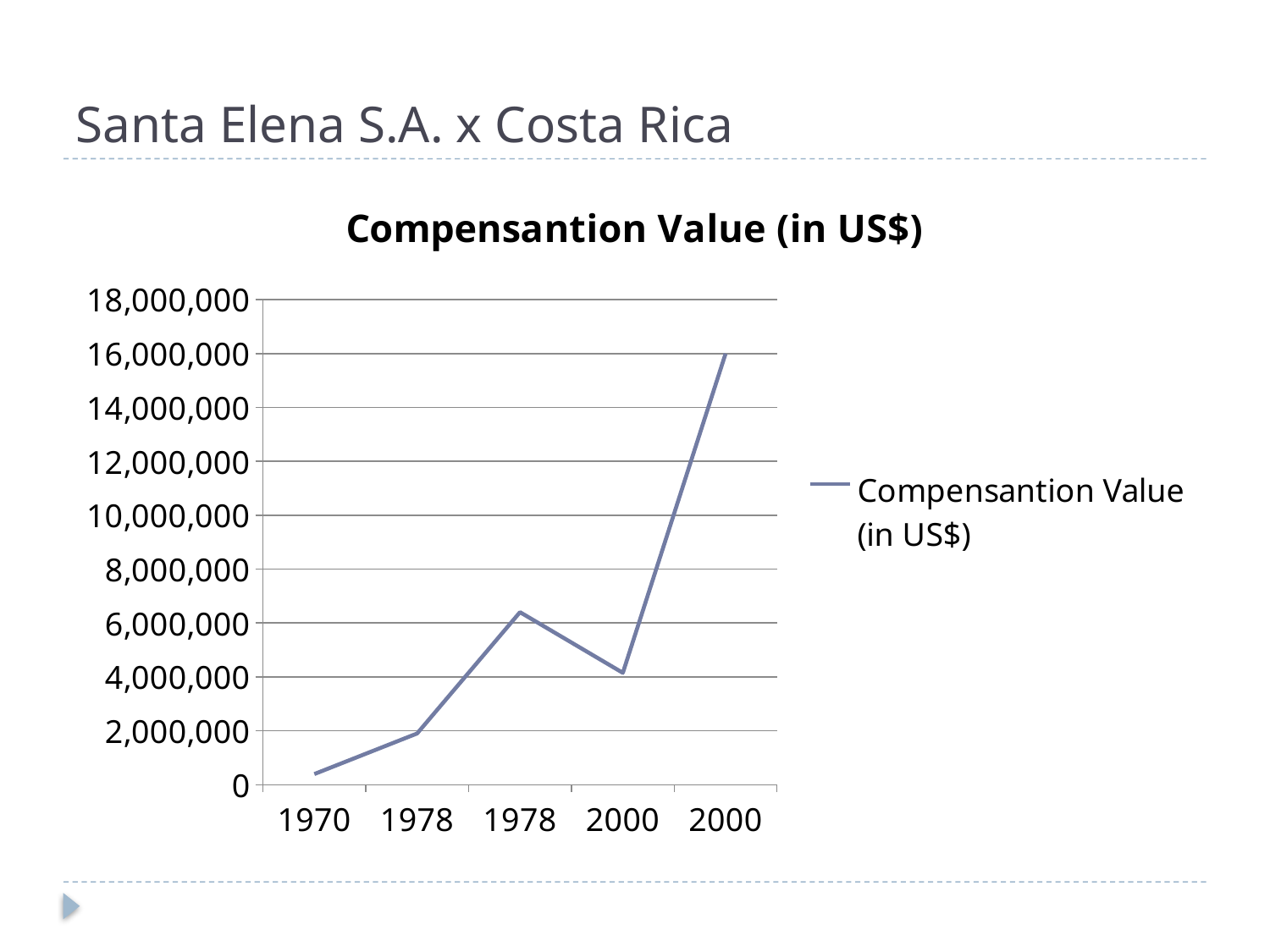
Is the compensation value at the second 1978 point greater or less than 4,000,000? greater What kind of chart is shown on the slide? line chart Is the compensation value for 1970 greater or less than 2,000,000? less Does the compensation value overall rise or fall from the first point to the last point along the x axis? rise What is the title of the chart? Compensantion Value (in US$) Which x-axis label corresponds to the lowest compensation value? 1970 How many data points are plotted on the line? 5 Is the compensation value at the last point (2000) greater or less than 14,000,000? greater Which x-axis label corresponds to the highest compensation value? 2000 (the last point) Which is larger, the compensation value at the first 1978 point or at the second 1978 point? the second 1978 point How many series does the legend list? 1